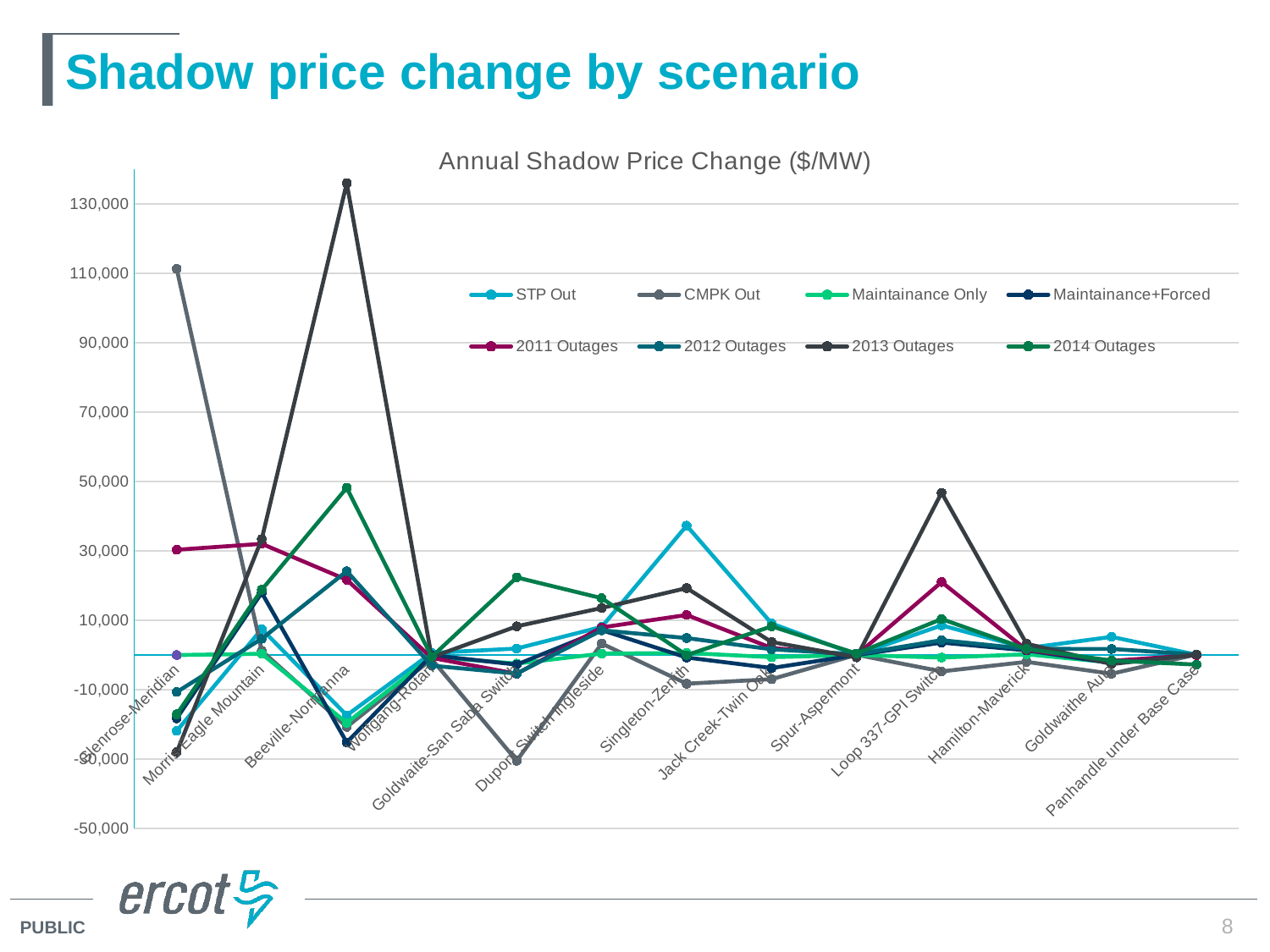
Is the value for CMPK Out at Glenrose-Meridian greater or less than 90,000? greater Is the value for 2013 Outages at Beeville-Normanna greater or less than 130,000? greater At which category does the 2013 Outages series reach its highest value? Beeville-Normanna At Loop 337-GPI Switch, which is larger: the 2013 Outages value or the 2011 Outages value? 2013 Outages How many categories are plotted along the x axis? 13 What is the title of the chart? Annual Shadow Price Change ($/MW) How many series does the legend list? 8 Is the value for STP Out at Singleton-Zenith greater or less than 30,000? greater At Singleton-Zenith, which is larger: the STP Out value or the 2013 Outages value? STP Out What kind of chart is shown on the slide? line chart Which series reaches the highest value anywhere on the chart? 2013 Outages